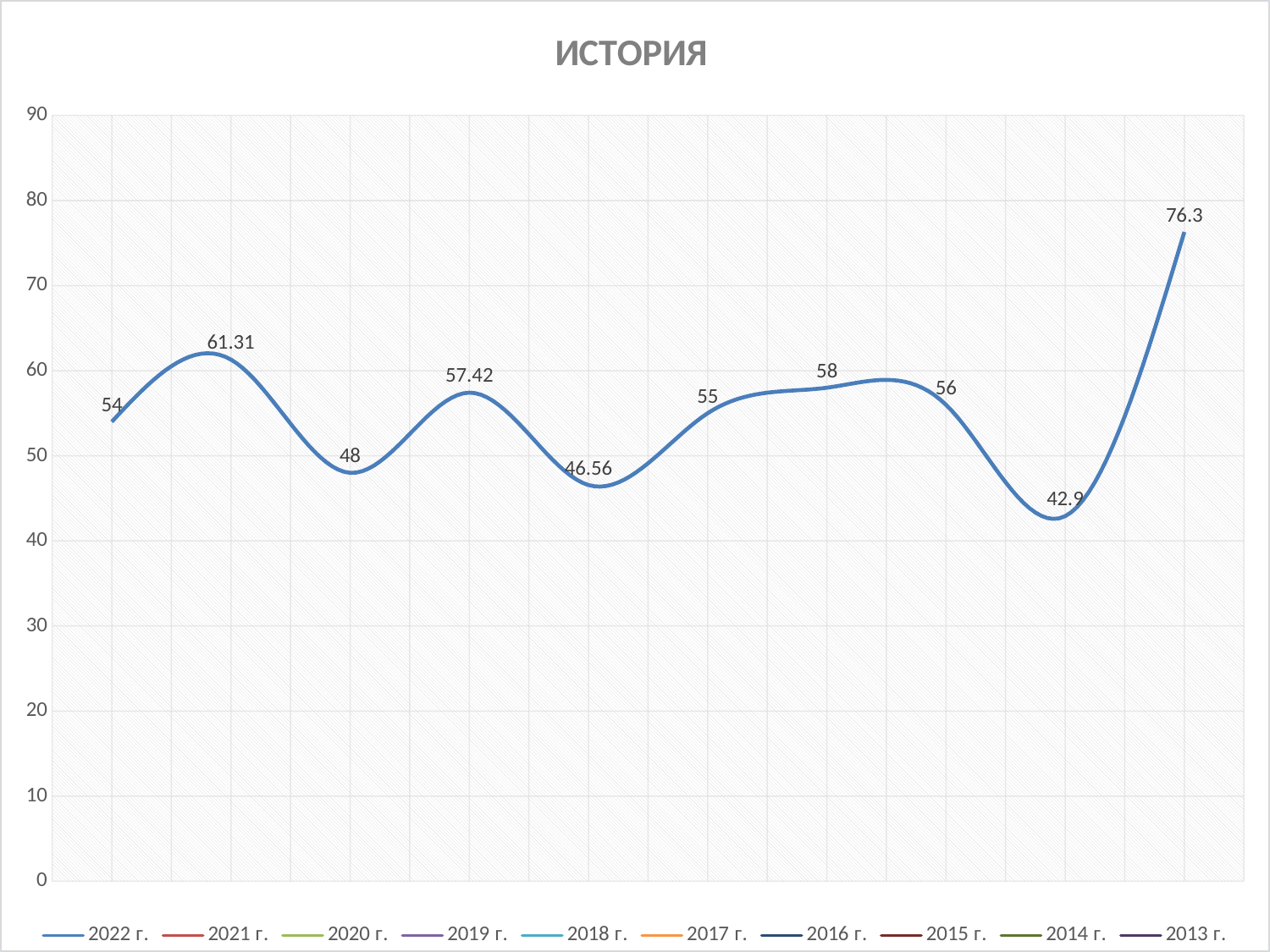
What is the highest value plotted on the line? 76.3 What is the value of the first (leftmost) data point on the line? 54 Which is larger: the second data point (61.31) or the fourth data point (57.42)? 61.31 How many entries does the legend list? 10 What kind of chart is shown on the slide? line chart What is the lowest value plotted on the line? 42.9 What is the title of the chart? ИСТОРИЯ Does the line rise or fall between the ninth and the tenth data point? rise What is the difference between the highest and lowest values on the line? 33.4 What is the value of the last (rightmost) data point on the line? 76.3 What is the difference between the last data point (76.3) and the first data point (54)? 22.3 How many data points are plotted on the line? 10